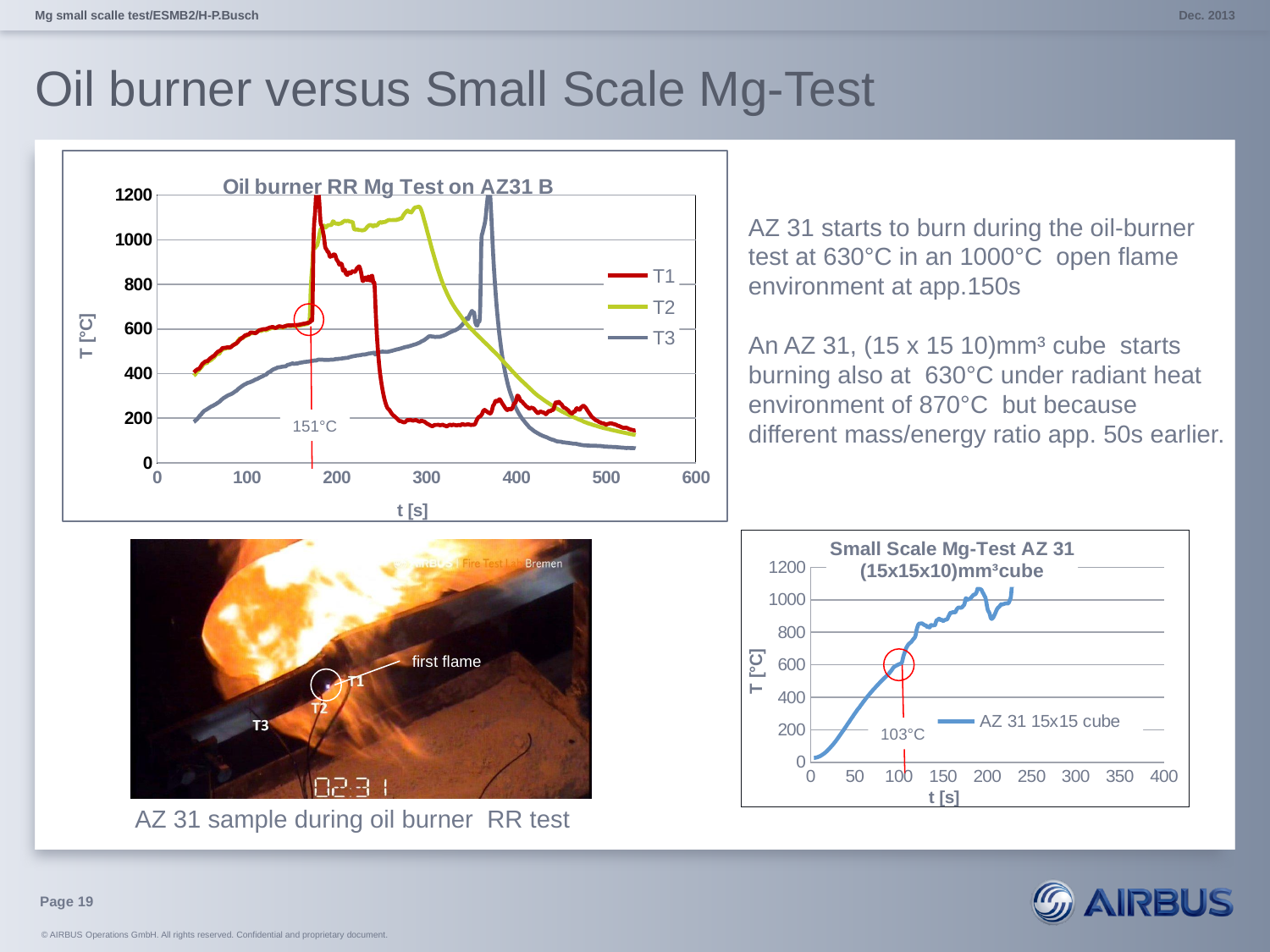
How many series does the legend of the 'Oil burner RR Mg Test on AZ31 B' chart list? 3 In the 'Oil burner RR Mg Test on AZ31 B' chart, is the T1 value at t = 300 s greater or less than 400? less What kind of chart is the 'Small Scale Mg-Test AZ 31 (15x15x10)mm³cube' chart? line chart In the 'Oil burner RR Mg Test on AZ31 B' chart, which series has the lowest value at t = 500 s? T3 In the 'Oil burner RR Mg Test on AZ31 B' chart, is the T2 value at t = 250 s greater or less than 1000? greater How many series does the legend of the 'Small Scale Mg-Test AZ 31 (15x15x10)mm³cube' chart list? 1 What are the legend entries of the 'Oil burner RR Mg Test on AZ31 B' chart? T1, T2, T3 What kind of chart is the 'Oil burner RR Mg Test on AZ31 B' chart? line chart In the 'Oil burner RR Mg Test on AZ31 B' chart, which is larger at t = 400 s, T1 or T2? T2 In the 'Small Scale Mg-Test AZ 31 (15x15x10)mm³cube' chart, is the value at t = 200 s greater or less than 800? greater In the 'Small Scale Mg-Test AZ 31 (15x15x10)mm³cube' chart, does the temperature generally rise or fall as time increases? rise